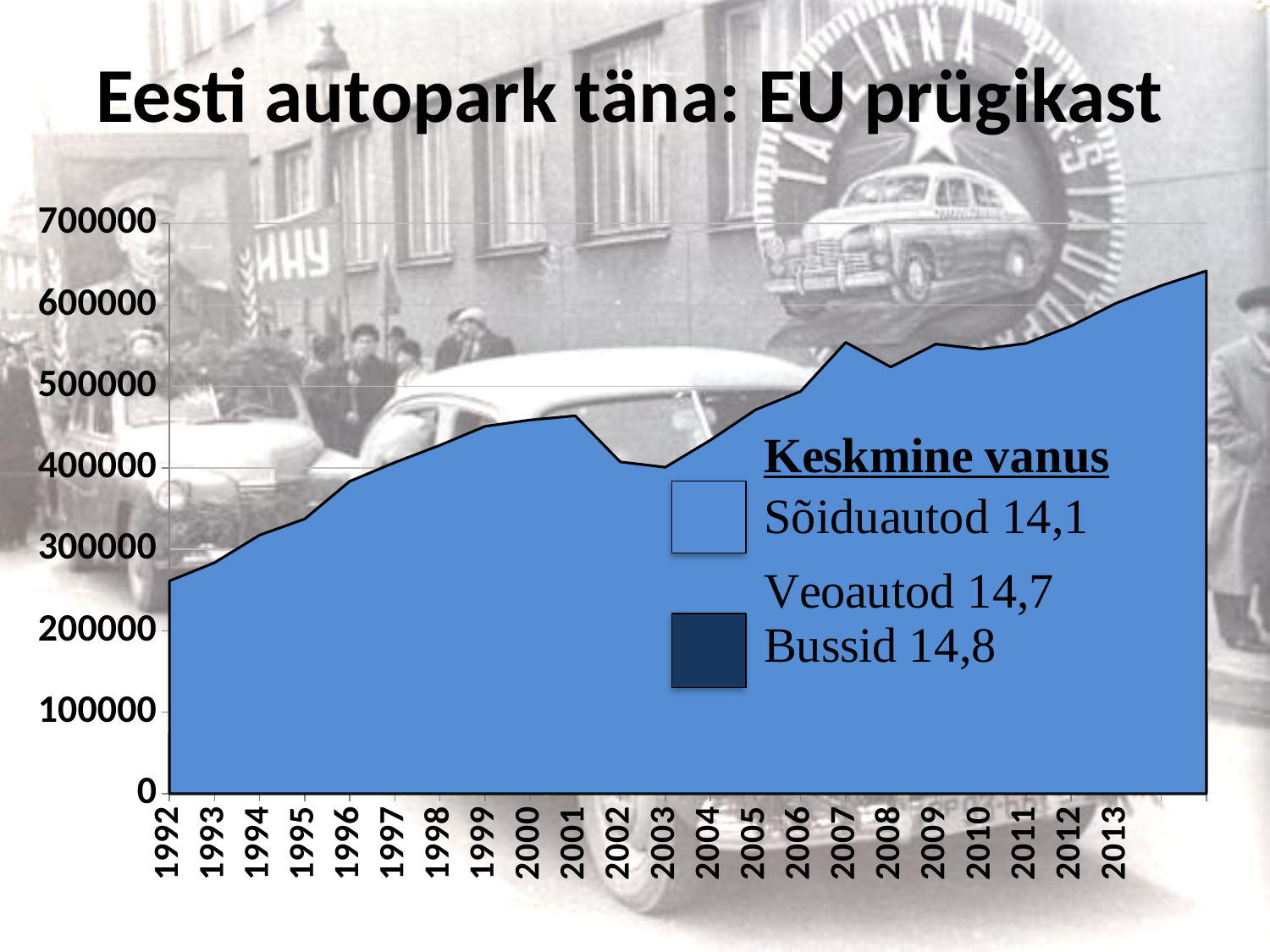
Is the value for 1992 greater or less than 300000? less Is the value for 1996 greater or less than 400000? less Which year has the larger value, 2007 or 2008? 2007 What kind of chart is shown on the slide? area chart According to the text box on the chart, what is the average age (Keskmine vanus) of Bussid? 14,8 Is the value for 2007 greater or less than 500000? greater What is the title of the slide containing the chart? Eesti autopark täna: EU prügikast Overall, do the values rise or fall from 1992 to 2013? rise Which year has the lowest value in the chart? 1992 How many years are shown on the x axis of the chart? 22